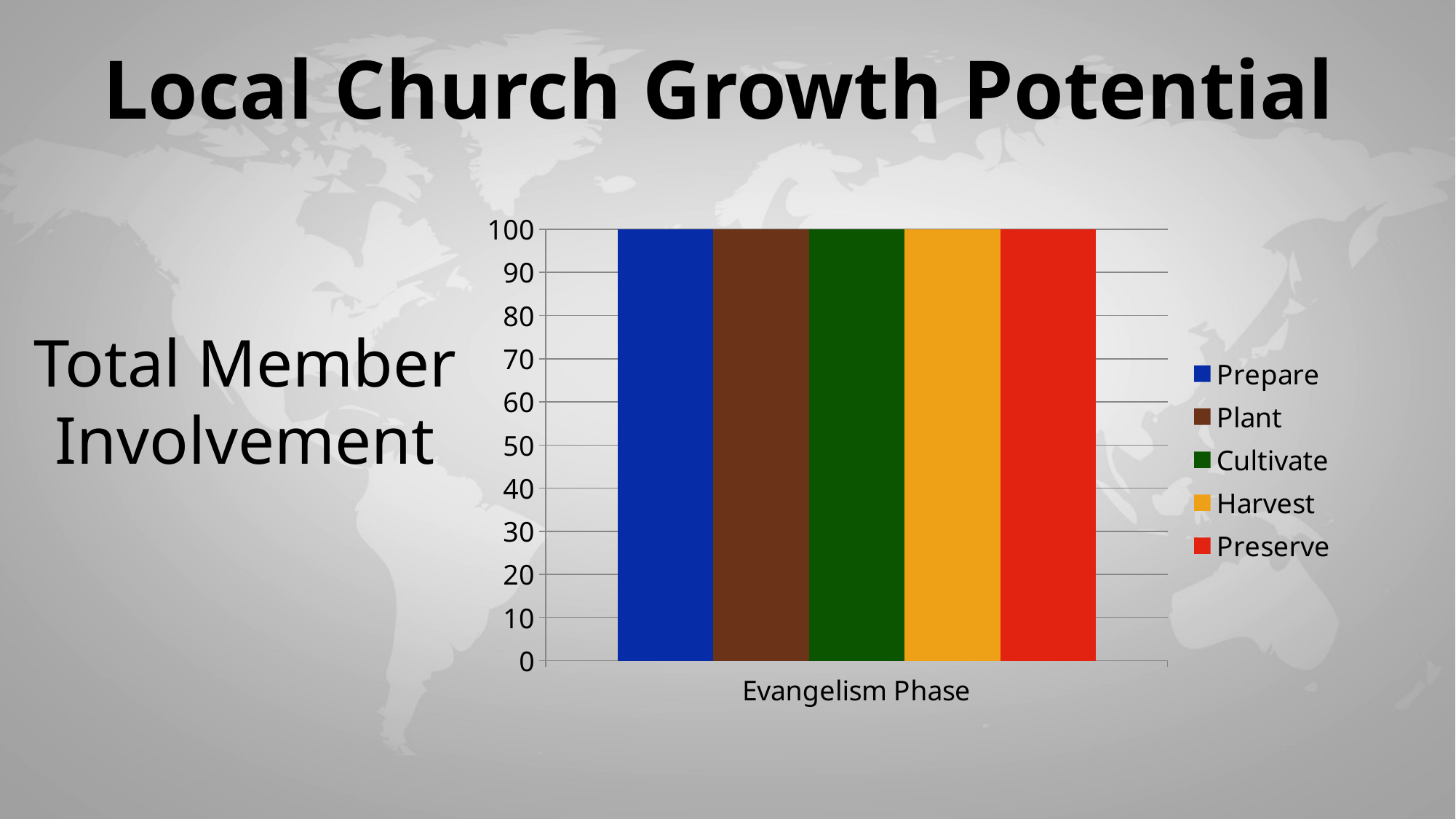
Is the value for Plant greater or less than 90? greater What is the highest value shown on the y axis? 100 How many series does the legend list? 5 Which legend entry is shown in green? Cultivate What is the value of the Preserve bar for Evangelism Phase? 100 What is the value of the Cultivate bar for Evangelism Phase? 100 What is the label on the x axis of the chart? Evangelism Phase What is the value of the Prepare bar for Evangelism Phase? 100 What kind of chart is shown on the slide? bar chart Is the value for Harvest greater or less than 50? greater How many categories are shown on the x axis? 1 What is the difference between the Prepare and Plant values? 0